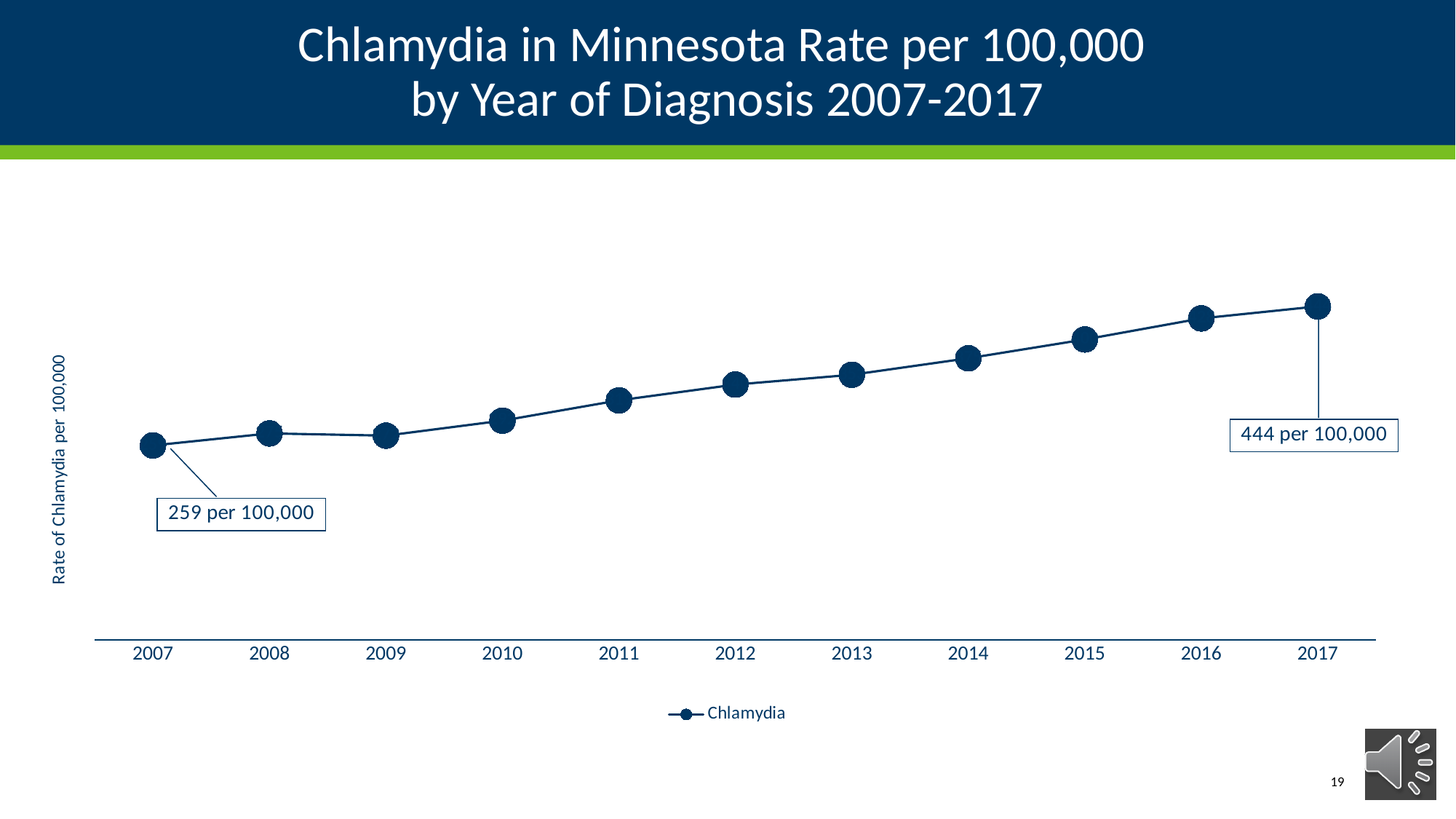
What kind of chart is shown on the slide? Line chart What is the chlamydia rate per 100,000 in Minnesota for 2017? 444 per 100,000 Which year has the lowest chlamydia rate on the chart? 2007 Which year has a higher chlamydia rate, 2008 or 2012? 2012 Does the chlamydia rate generally rise or fall from 2007 to 2017? Rise Which year has a higher chlamydia rate, 2015 or 2010? 2015 What is the label of the series shown in the legend? Chlamydia How many series does the legend list? 1 What is the chlamydia rate per 100,000 in Minnesota for 2007? 259 per 100,000 How many years are plotted on the chart? 11 Which year has the highest chlamydia rate on the chart? 2017 By how much did the chlamydia rate per 100,000 increase from 2007 to 2017? 185